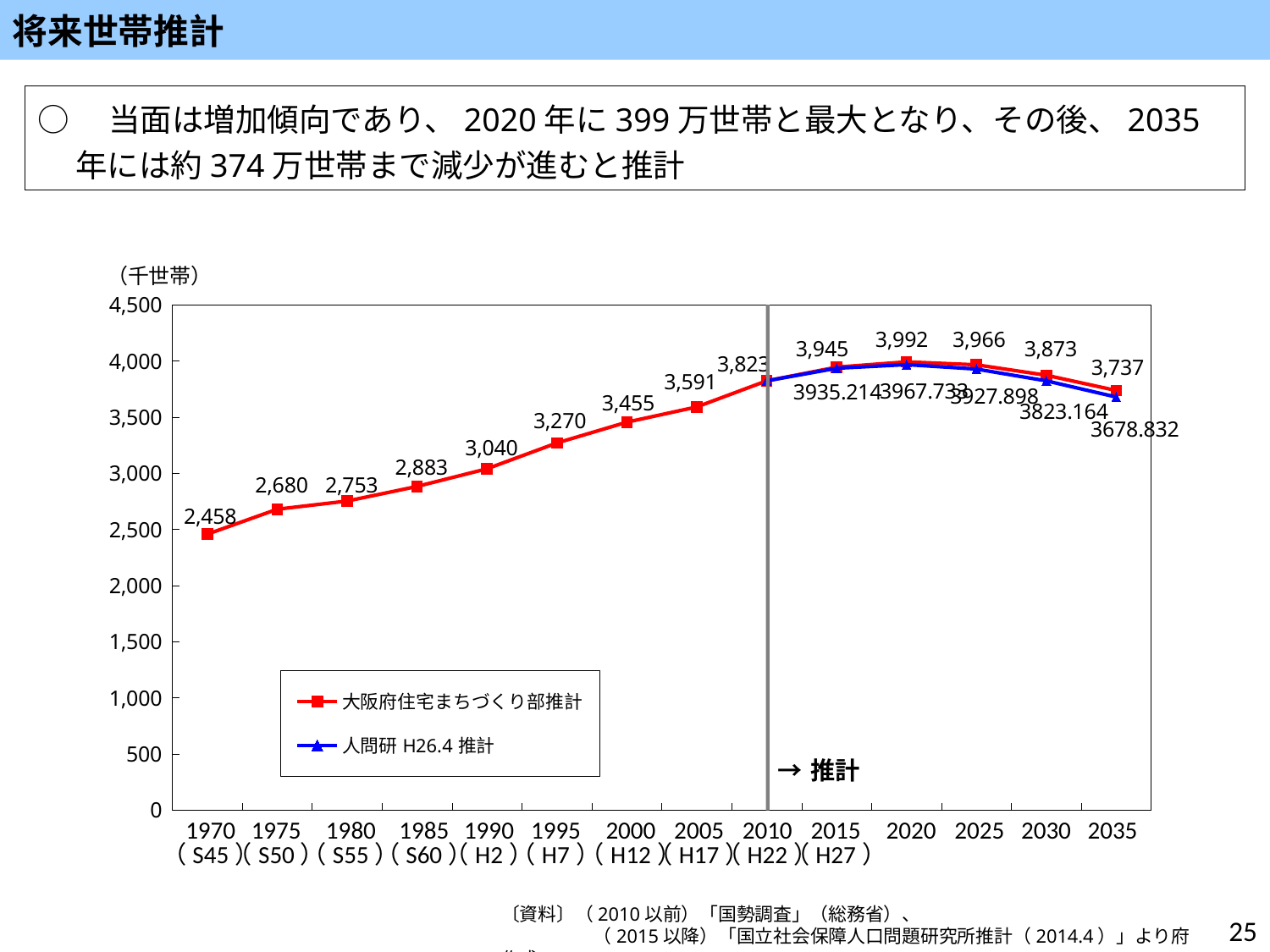
What kind of chart is shown on the slide? line chart What is the value of the 人間研 H26.4 推計 series in 2035? 3678.832 Which is larger in 2030: the 大阪府住宅まちづくり部推計 value or the 人間研 H26.4 推計 value? 大阪府住宅まちづくり部推計 Is the 大阪府住宅まちづくり部推計 value for 1990 greater or less than 3,000? greater In which year does the 大阪府住宅まちづくり部推計 series have its lowest value? 1970 In which year does the 大阪府住宅まちづくり部推計 series reach its highest value? 2020 Does the 大阪府住宅まちづくり部推計 series rise or fall between 1970 and 2010? rise What is the value of the 大阪府住宅まちづくり部推計 series in 1970? 2,458 How many series does the legend list? 2 What is the difference between the 大阪府住宅まちづくり部推計 values for 2035 and 1970? 1,279 What is the value of the 大阪府住宅まちづくり部推計 series in 2020? 3,992 How many years are shown on the x axis? 14